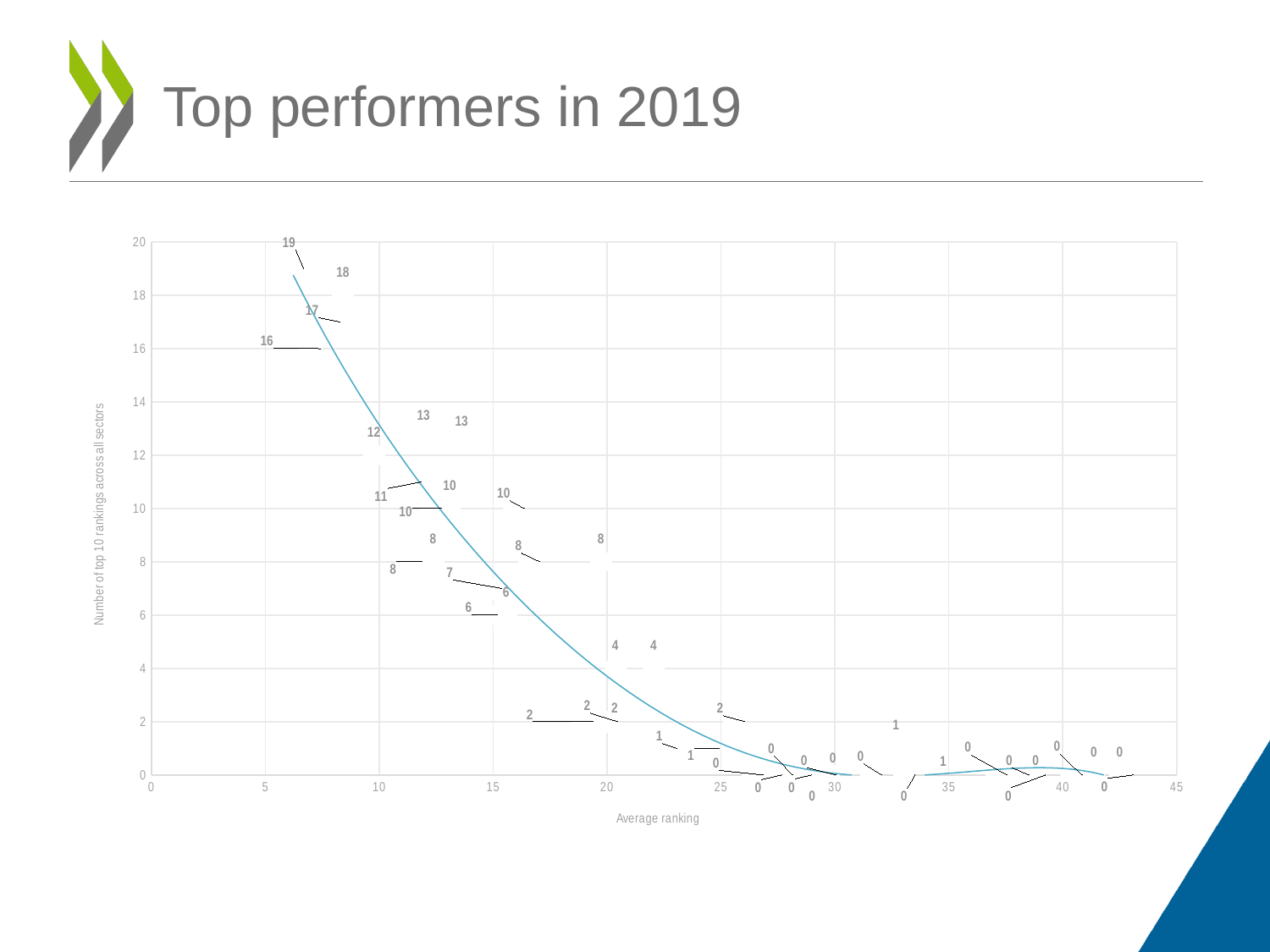
How many points on the chart are labelled 19? 1 Do points with an average ranking below 10 have more or fewer top 10 rankings than points with an average ranking above 30? more As the average ranking increases along the x axis, does the number of top 10 rankings rise or fall? fall Is the average ranking of the point labelled 19 greater or less than 10? less What is the lowest number of top 10 rankings shown by a data label on the chart? 0 What is the label of the horizontal axis? Average ranking What is the difference between the highest and lowest data label values on the chart? 19 What is the highest number of top 10 rankings shown by a data label on the chart? 19 What kind of chart is shown on the slide? scatter chart Is the number of top 10 rankings for the point labelled 16 greater or less than 10? greater What is the title of the chart on the slide? Top performers in 2019